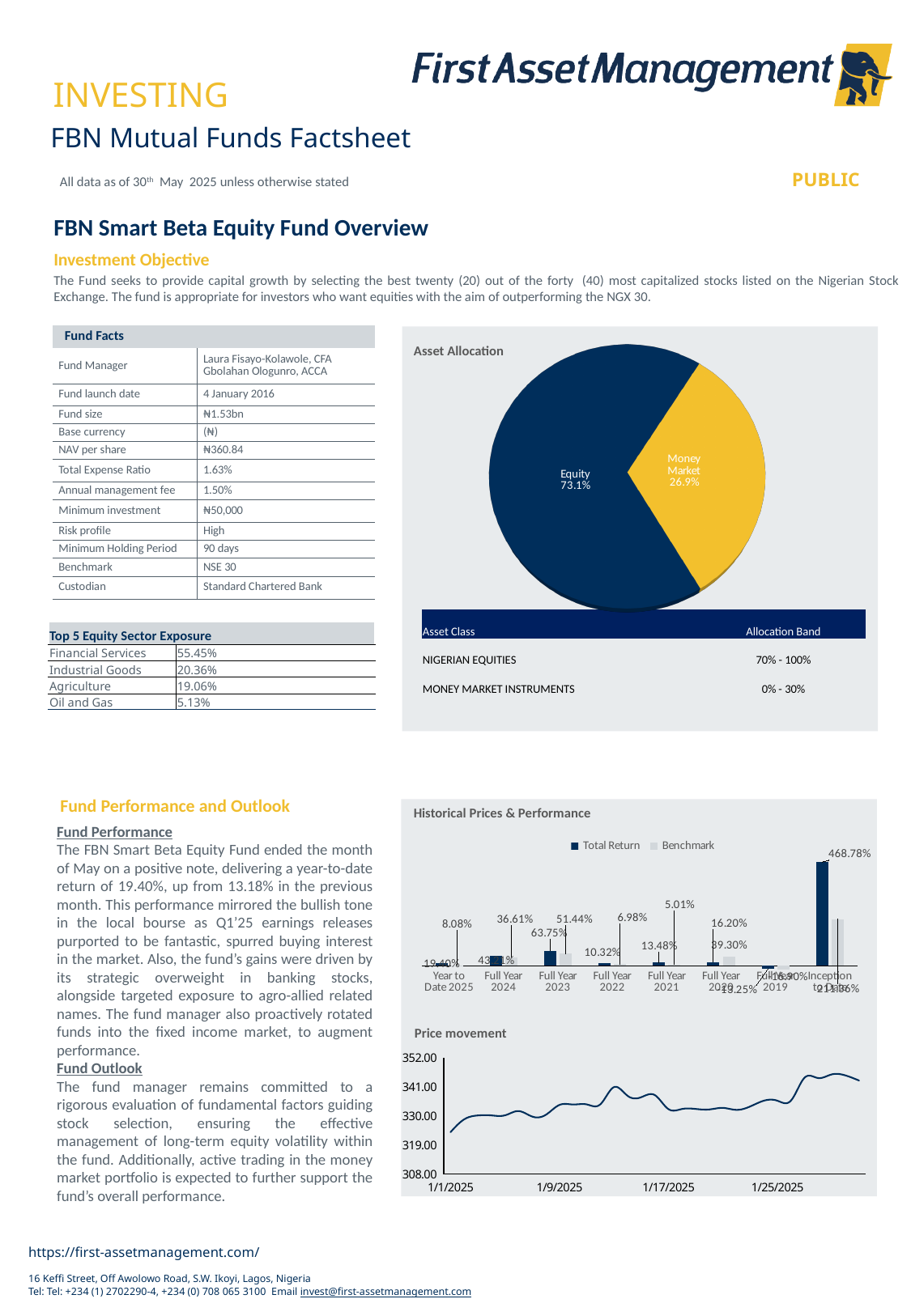
In the Asset Allocation pie chart, what share of the fund is allocated to Equity? 73.1% In the Historical Prices & Performance chart, what is the Total Return for Full Year 2023? 63.75% How many slices does the Asset Allocation pie chart have? 2 In the Price movement chart, do prices generally rise or fall from 1/1/2025 to 1/25/2025? Rise How many series does the legend of the Historical Prices & Performance chart list? 2 In the Asset Allocation pie chart, which slice is larger, Equity or Money Market? Equity In the Price movement chart, is the value on 1/1/2025 greater or less than 330.00? less In the Historical Prices & Performance chart, which period has the highest Total Return? Inception to Date What kind of chart is the Asset Allocation chart? Pie chart In the Historical Prices & Performance chart, what is the Total Return for Inception to Date? 468.78% In the Asset Allocation pie chart, what share of the fund is allocated to Money Market? 26.9% What kind of chart is the Historical Prices & Performance chart? Bar chart